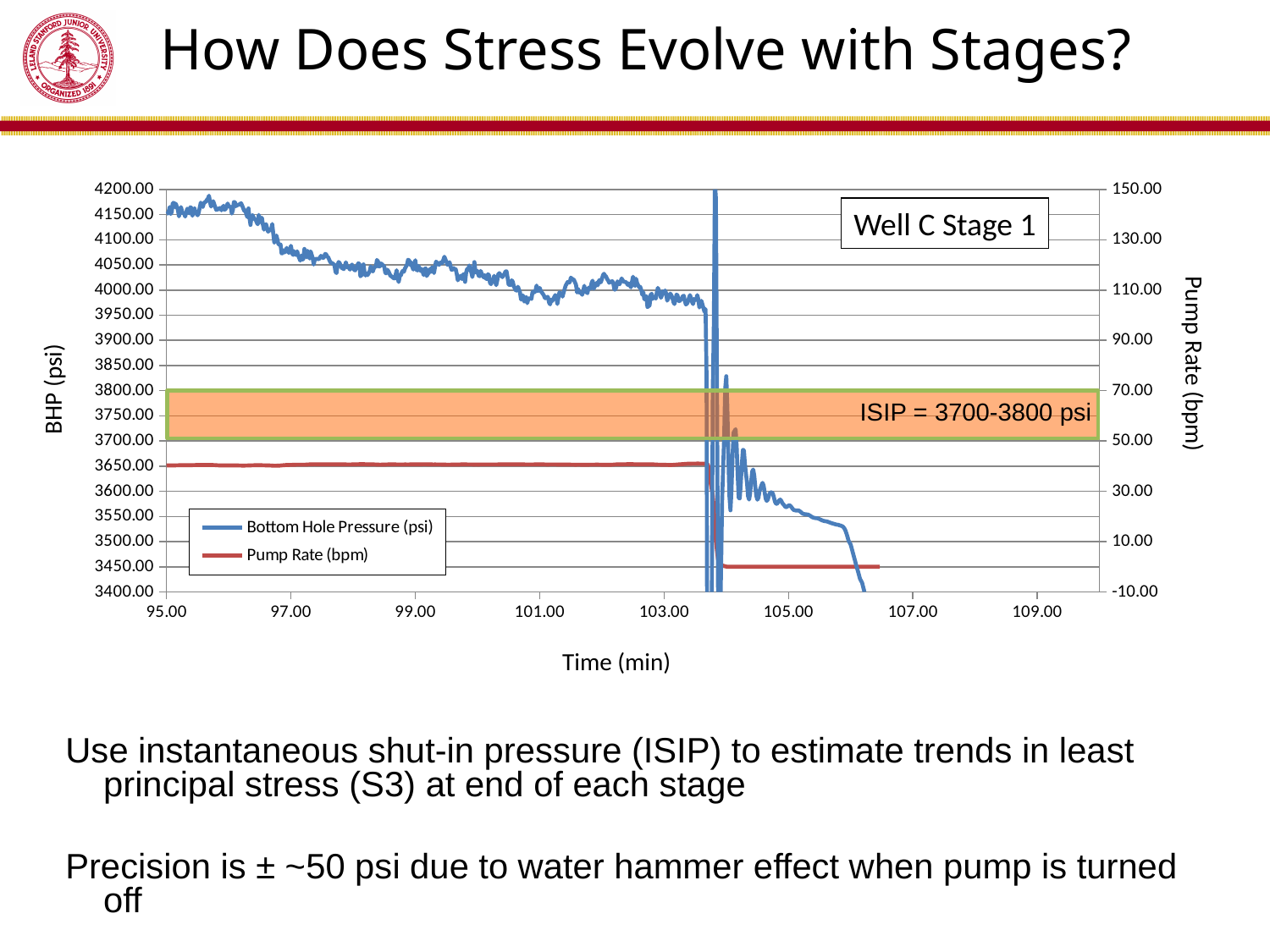
Is the Bottom Hole Pressure at 103 minutes greater or less than 4050? less Is the Pump Rate at 100 minutes greater or less than 50 bpm? less What are the two series named in the chart legend? Bottom Hole Pressure (psi) and Pump Rate (bpm) Does the Bottom Hole Pressure rise or fall between 95 and 103 minutes? fall Is the Pump Rate at 105 minutes greater or less than 10 bpm? less What ISIP range is annotated on the chart? 3700-3800 psi How many series does the chart legend list? 2 What kind of chart is shown on the slide? line chart What is the label of the chart's x axis? Time (min) Which well and stage does the chart annotation say the data is from? Well C Stage 1